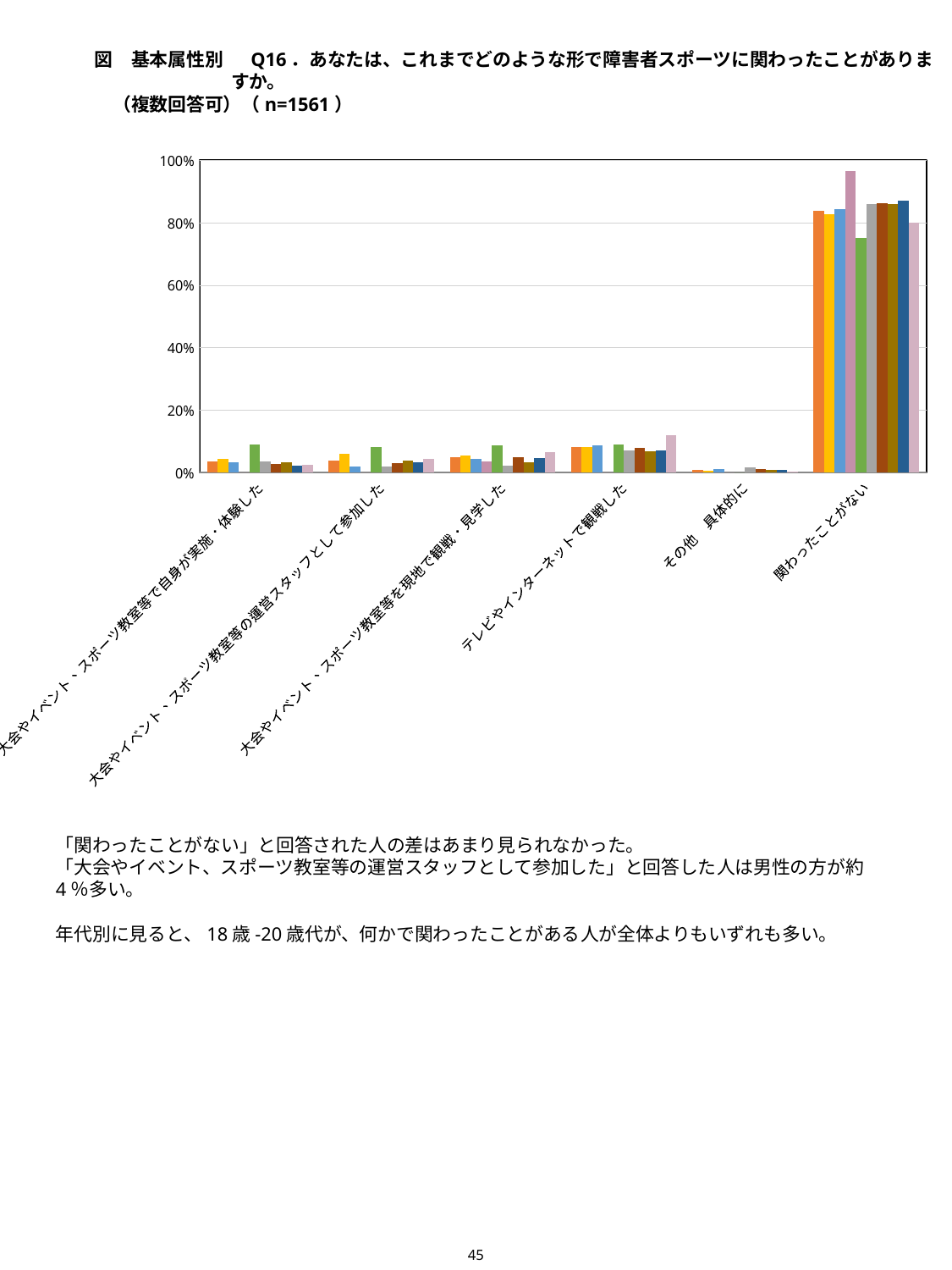
Which category has larger values: 大会やイベント、スポーツ教室等を現地で観戦・見学した or その他 具体的に? 大会やイベント、スポーツ教室等を現地で観戦・見学した What kind of chart is shown on the slide? bar chart What is the maximum value shown on the vertical axis of the chart? 100% Which category has the lowest bars in the chart? その他 具体的に Which category has the highest bars in the chart? 関わったことがない Are the values for 関わったことがない greater or less than 60%? greater Are the values for テレビやインターネットで観戦した greater or less than 20%? less How many categories are shown along the x axis of the chart? 6 Which category has larger values: 関わったことがない or テレビやインターネットで観戦した? 関わったことがない What sample size (n) is stated in the chart title? n=1561 Are the values for その他 具体的に greater or less than 20%? less